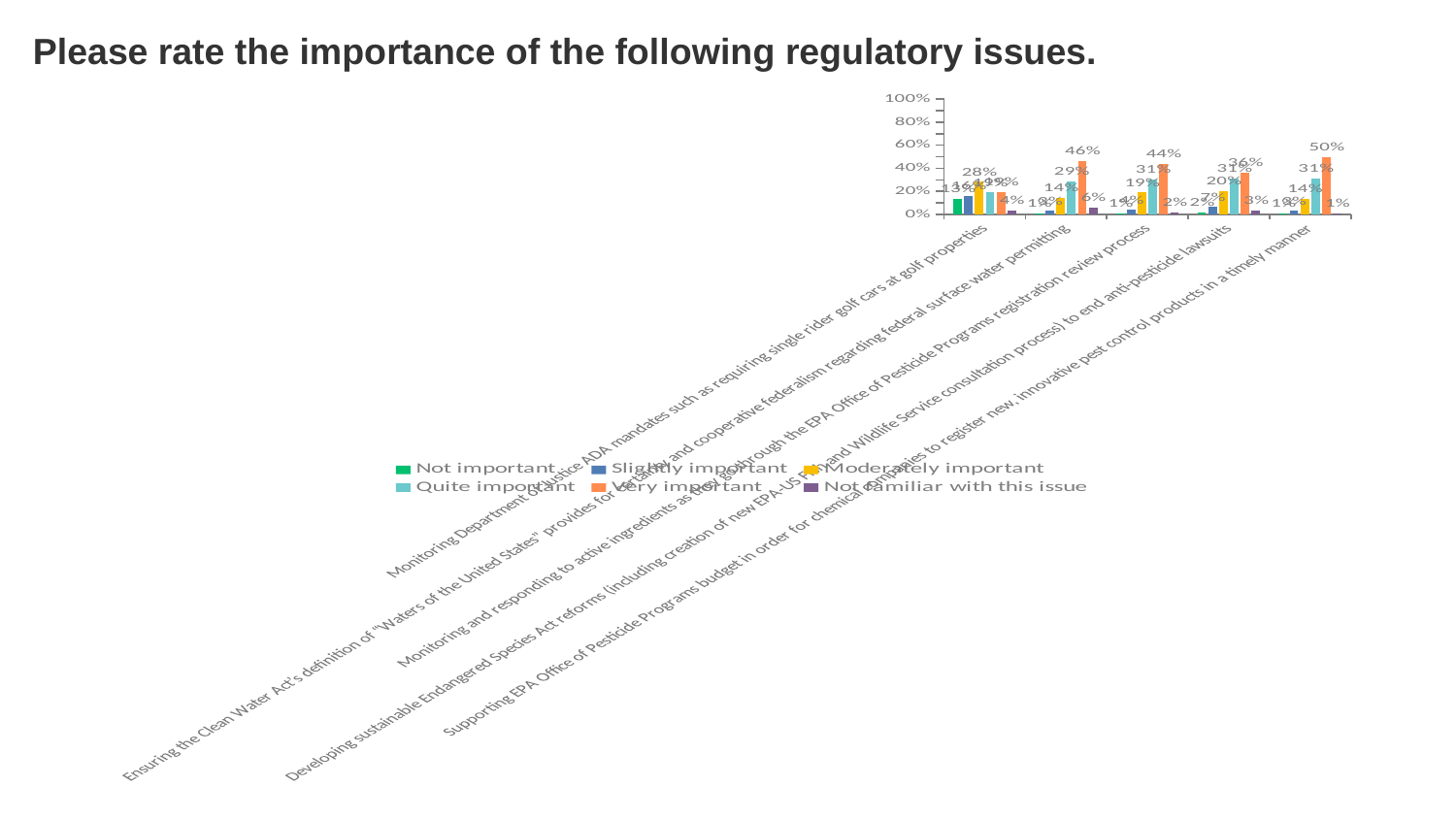
What percentage rated 'Ensuring the Clean Water Act's definition of "Waters of the United States"...' as Very important? 46% What percentage rated 'Developing sustainable Endangered Species Act reforms...' as Very important? 36% How many regulatory issues (categories) are plotted on the x axis? 5 Which regulatory issue has the highest Very important percentage? Supporting EPA Office of Pesticide Programs budget in order for chemical companies to register new, innovative pest control products in a timely manner What percentage rated 'Supporting EPA Office of Pesticide Programs budget...' as Very important? 50% How many series does the legend list? 6 Which has a larger Very important percentage: 'Ensuring the Clean Water Act's definition...' or 'Developing sustainable Endangered Species Act reforms...'? Ensuring the Clean Water Act's definition of "Waters of the United States"... What is the first entry listed in the legend? Not important Is the Very important value for 'Monitoring and responding to active ingredients... registration review process' greater or less than 40%? greater What is the difference in the Very important percentage between 'Supporting EPA Office of Pesticide Programs budget...' and 'Ensuring the Clean Water Act's definition...'? 4 percentage points What percentage rated 'Monitoring Department of Justice ADA mandates...' as Moderately important? 28% What kind of chart is shown on the slide? Bar chart